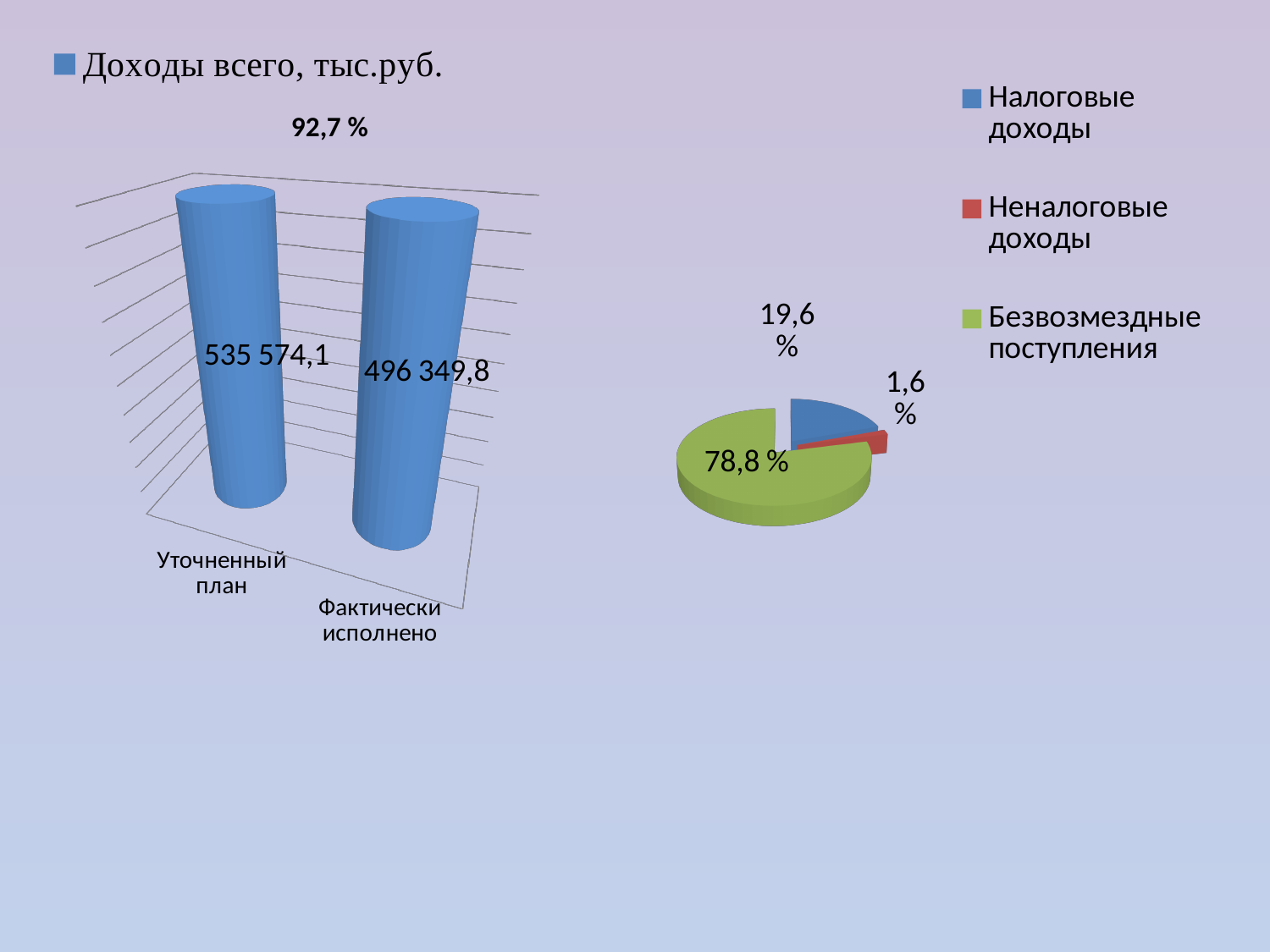
On the right pie chart, which slice is the smallest? Неналоговые доходы What kind of chart is the left chart (Доходы всего, тыс.руб.)? bar chart On the left chart (Доходы всего, тыс.руб.), which category has the higher value? Уточненный план On the left chart (Доходы всего, тыс.руб.), what is the value for Уточненный план? 535 574,1 On the right pie chart, what share does Безвозмездные поступления have? 78,8 % How many entries does the legend of the right pie chart list? 3 On the right pie chart, what share does Налоговые доходы have? 19,6 % On the left chart (Доходы всего, тыс.руб.), how many categories are shown? 2 On the left chart (Доходы всего, тыс.руб.), what percentage is printed above the bars? 92,7 % On the left chart (Доходы всего, тыс.руб.), what is the value for Фактически исполнено? 496 349,8 On the left chart (Доходы всего, тыс.руб.), what is the difference between Уточненный план and Фактически исполнено? 39 224,3 On the left chart (Доходы всего, тыс.руб.), which category has the lower value? Фактически исполнено